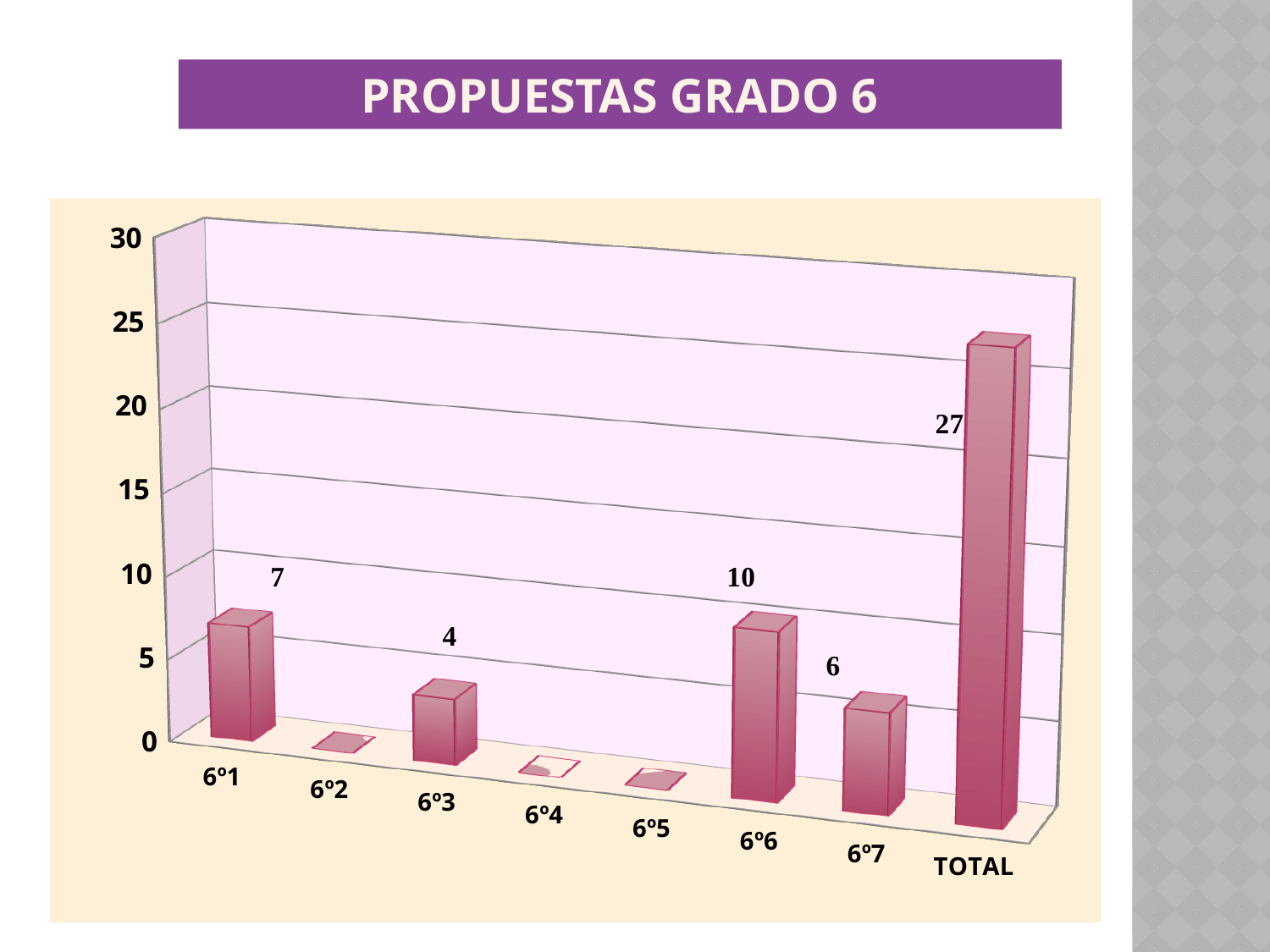
Is the value for TOTAL greater or less than 25? greater What is the difference between the values for 6º6 and 6º1? 3 What is the value for 6º7? 6 What is the value for 6º6? 10 What is the value for 6º3? 4 What is the value for TOTAL? 27 What is the title of the chart? PROPUESTAS GRADO 6 What is the value for 6º1? 7 Which category has the tallest bar? TOTAL What is the difference between the values for TOTAL and 6º6? 17 Which is larger, the value for 6º3 or the value for 6º7? 6º7 How many categories are shown on the x axis? 8